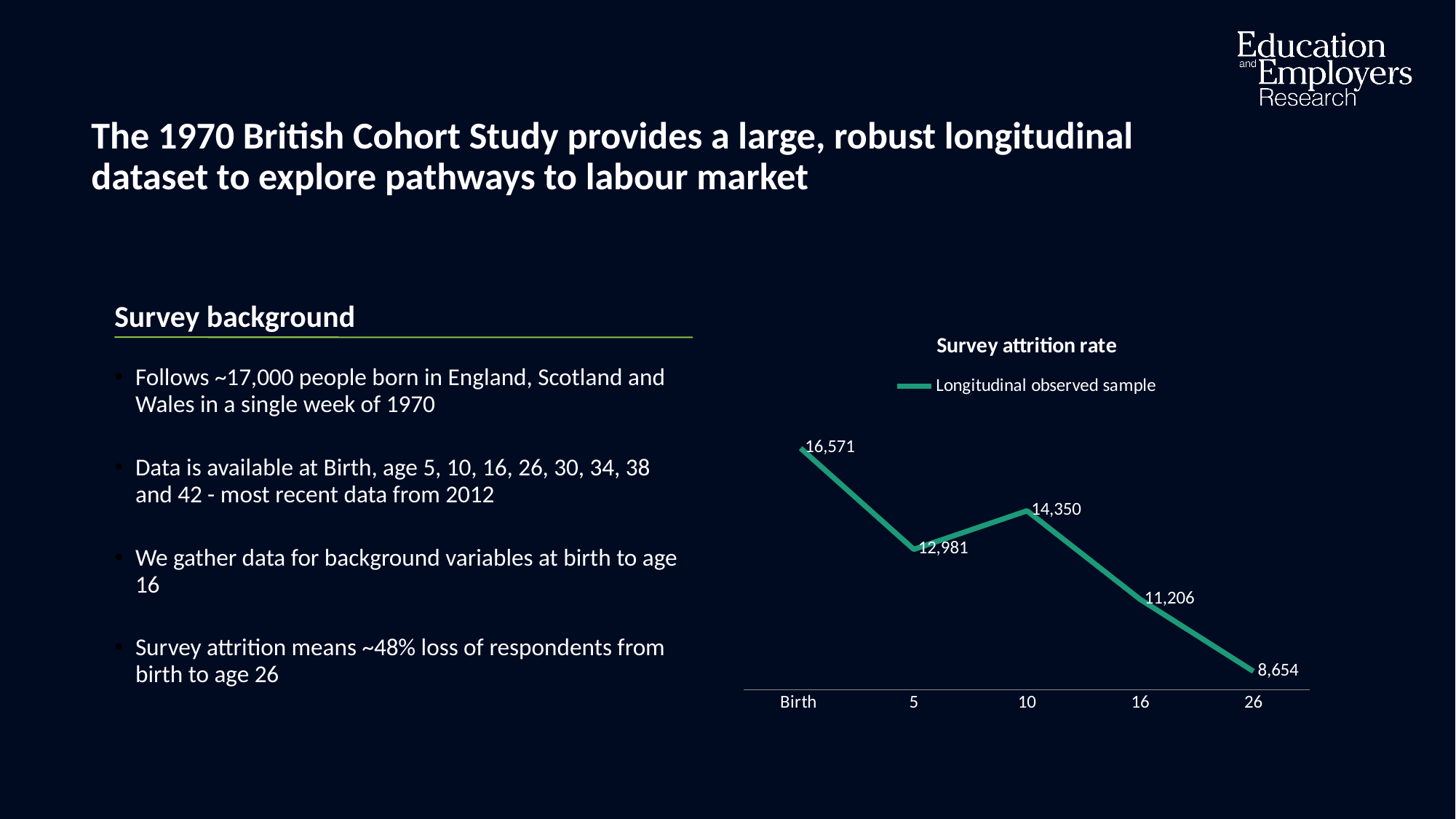
At which age point is the longitudinal observed sample highest? Birth What is the value of the longitudinal observed sample at age 10? 14,350 What is the value of the longitudinal observed sample at Birth? 16,571 How many series does the legend list? 1 What is the difference between the sample at Birth and the sample at age 26? 7,917 At which age point is the longitudinal observed sample lowest? 26 What is the difference between the sample at age 10 and the sample at age 5? 1,369 How many data points are plotted on the line? 5 Which is larger, the sample at age 5 or the sample at age 16? age 5 What kind of chart is shown on the slide? line chart What is the value of the longitudinal observed sample at age 26? 8,654 What is the title of the chart? Survey attrition rate